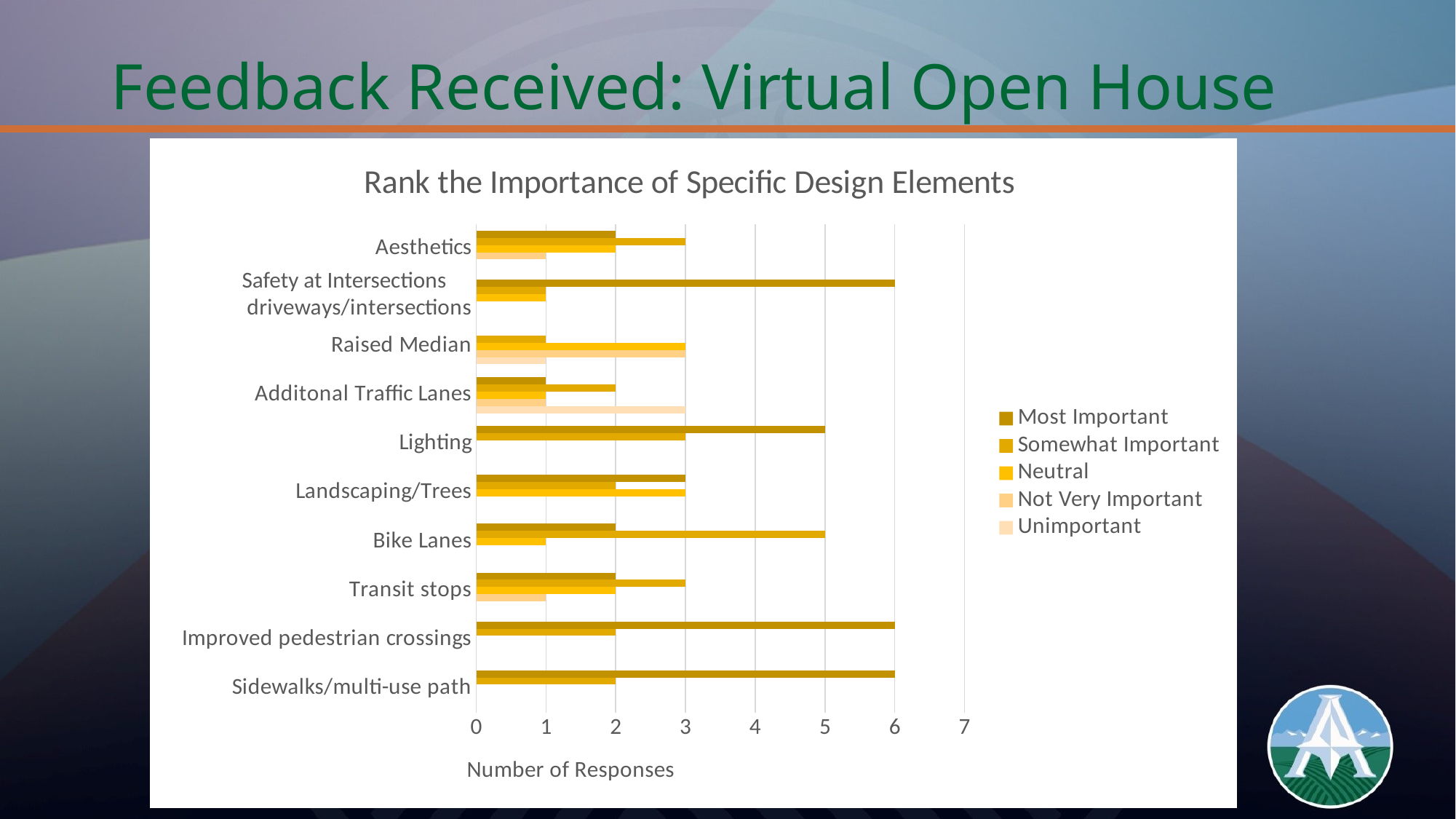
Is the number of Most Important responses for Sidewalks/multi-use path greater or less than 4? greater How many design element categories are listed on the chart? 10 Which category has the highest number of Somewhat Important responses? Bike Lanes How many responses rated Bike Lanes as Somewhat Important? 5 What is the difference between the Most Important responses for Safety at Intersections driveways/intersections and for Raised Median? 6 Which has more Most Important responses: Lighting or Aesthetics? Lighting What kind of chart is shown on the slide? Bar chart What is the label on the horizontal axis of the chart? Number of Responses How many responses rated Improved pedestrian crossings as Most Important? 6 How many series does the legend list? 5 How many responses rated Lighting as Most Important? 5 How many responses rated Additonal Traffic Lanes as Unimportant? 3